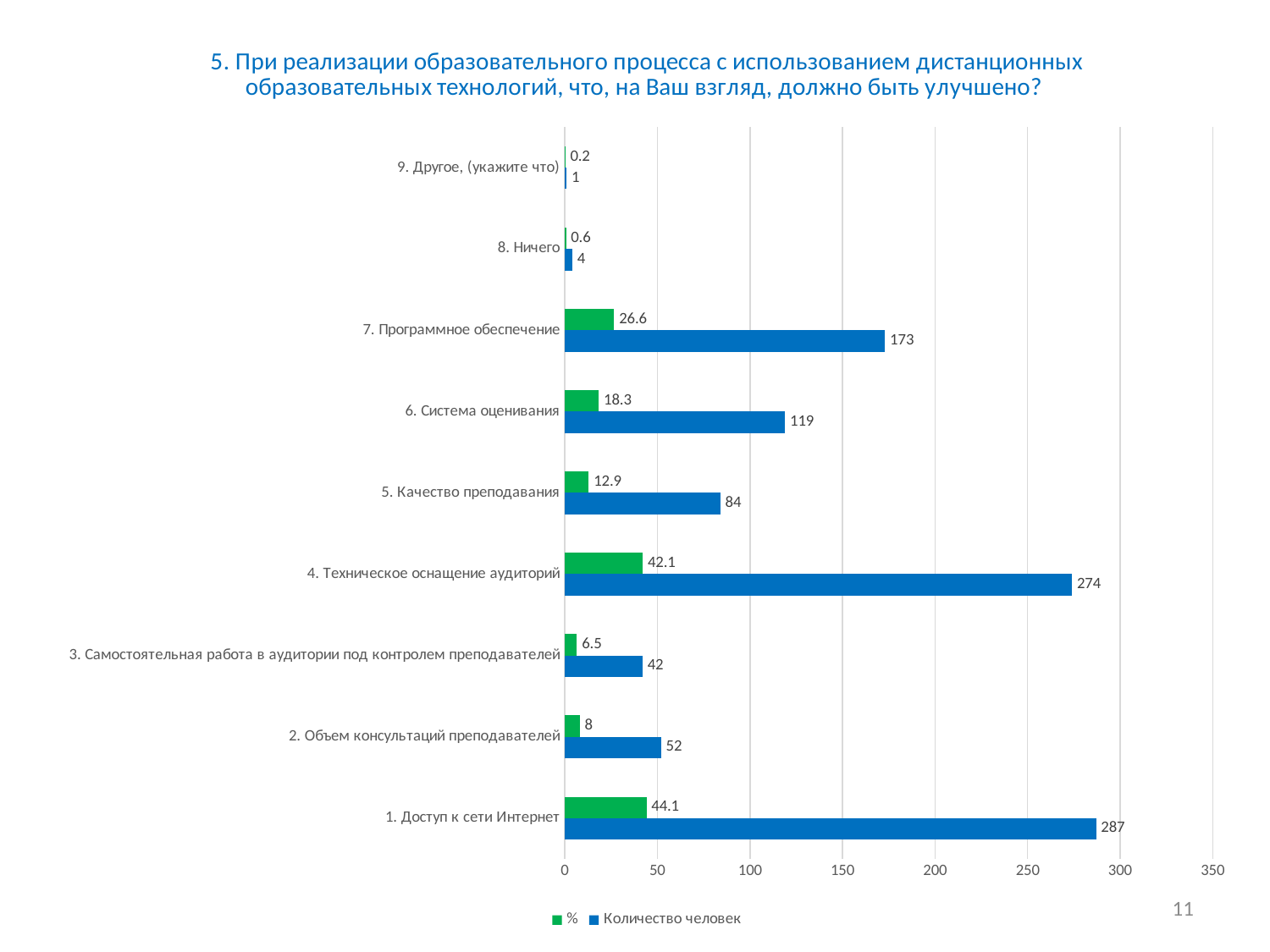
How many series does the legend list? 2 What is the difference in "Количество человек" between "4. Техническое оснащение аудиторий" and "6. Система оценивания"? 155 What is the value of "Количество человек" for "7. Программное обеспечение"? 173 Is the "Количество человек" value for "6. Система оценивания" greater or less than 100? greater Which category has the highest value of "Количество человек"? 1. Доступ к сети Интернет Which category has the lowest value of "Количество человек"? 9. Другое, (укажите что) Which has a larger "Количество человек" value: "2. Объем консультаций преподавателей" or "5. Качество преподавания"? 5. Качество преподавания What is the "%" value for "4. Техническое оснащение аудиторий"? 42.1 What kind of chart is shown on the slide? bar chart Which colour represents the "%" series in the chart? green What is the value of "Количество человек" for "1. Доступ к сети Интернет"? 287 How many categories are shown on the chart? 9